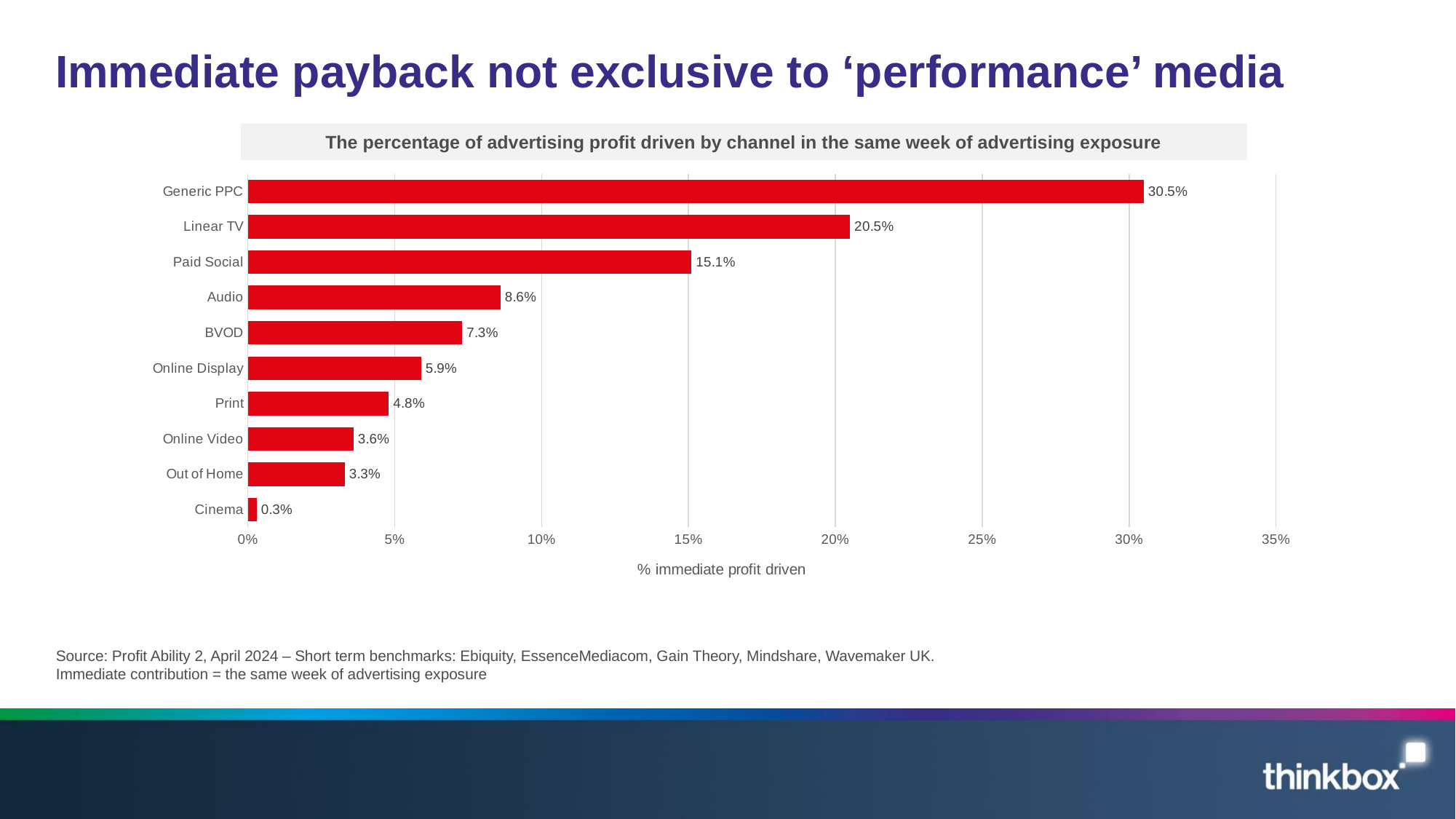
What is the value for Out of Home? 3.3% Which is larger, the value for Online Display or the value for Print? Online Display Is the value for Paid Social greater or less than 10%? greater How many channels are shown in the chart? 10 What is the value for Audio? 8.6% What kind of chart is shown on the slide? Bar chart Which channel has the highest percentage of immediate profit driven? Generic PPC What is the difference between the values for Paid Social and BVOD? 7.8 percentage points Which channel has the lowest percentage of immediate profit driven? Cinema What is the difference between the values for Generic PPC and Linear TV? 10 percentage points What is the value for Linear TV? 20.5% What is the label on the horizontal axis of the chart? % immediate profit driven